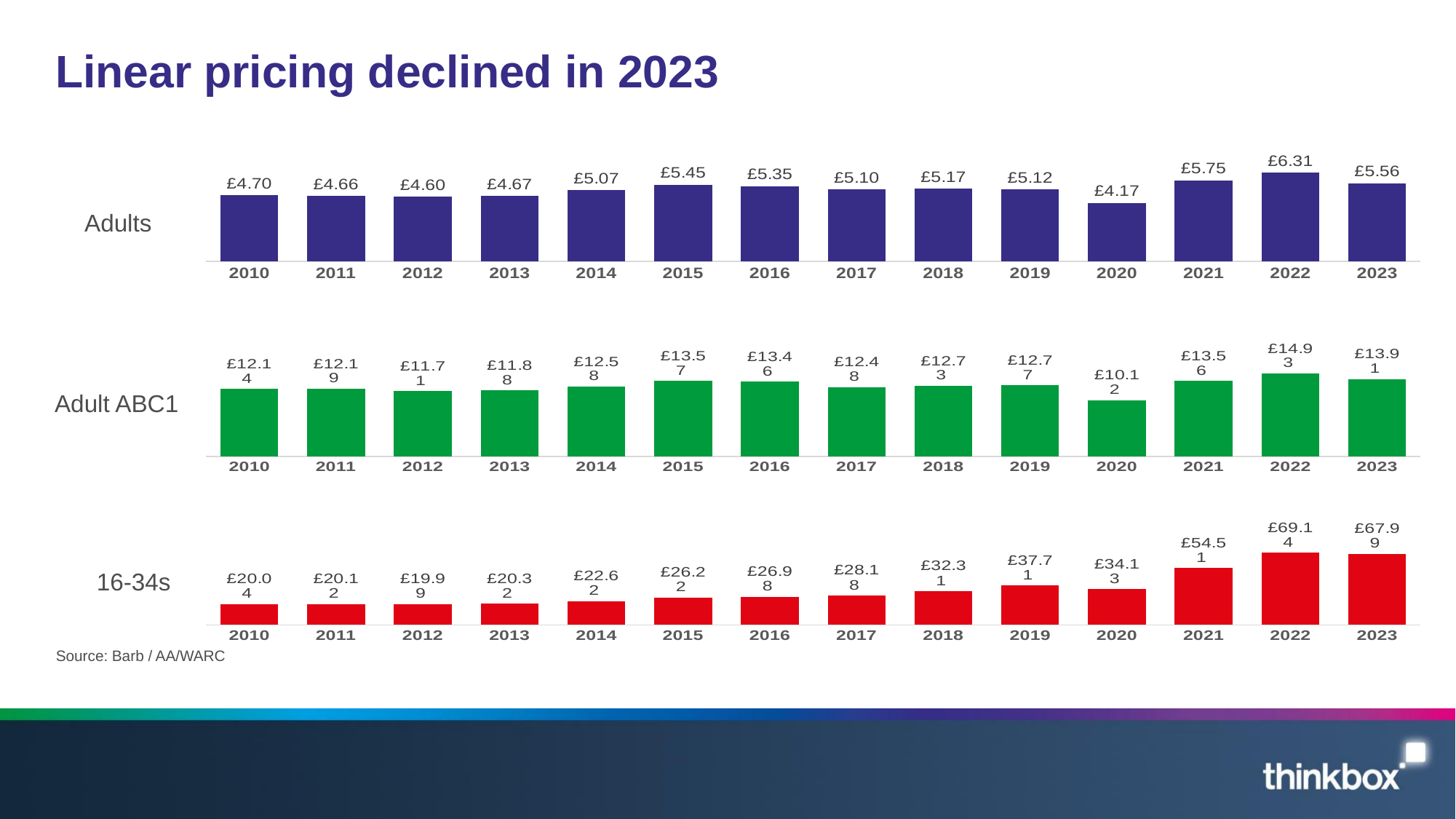
In the Adults chart, which year has the lowest value? 2020 How many years are shown in the Adults chart? 14 In the Adults chart, what is the difference between the 2022 value and the 2023 value? £0.75 In the Adult ABC1 chart, what is the value for 2020? £10.12 In the 16-34s chart, what is the value for 2022? £69.14 In the Adults chart, which is larger, the value for 2015 or the value for 2016? 2015 What colour are the bars in the 16-34s chart? Red In the 16-34s chart, do the values generally rise or fall from 2010 to 2023? Rise In the Adults chart, what is the value for 2023? £5.56 In the Adults chart, which year has the highest value? 2022 In the Adult ABC1 chart, which year has the lowest value? 2020 What kind of chart is the Adult ABC1 chart? Bar chart